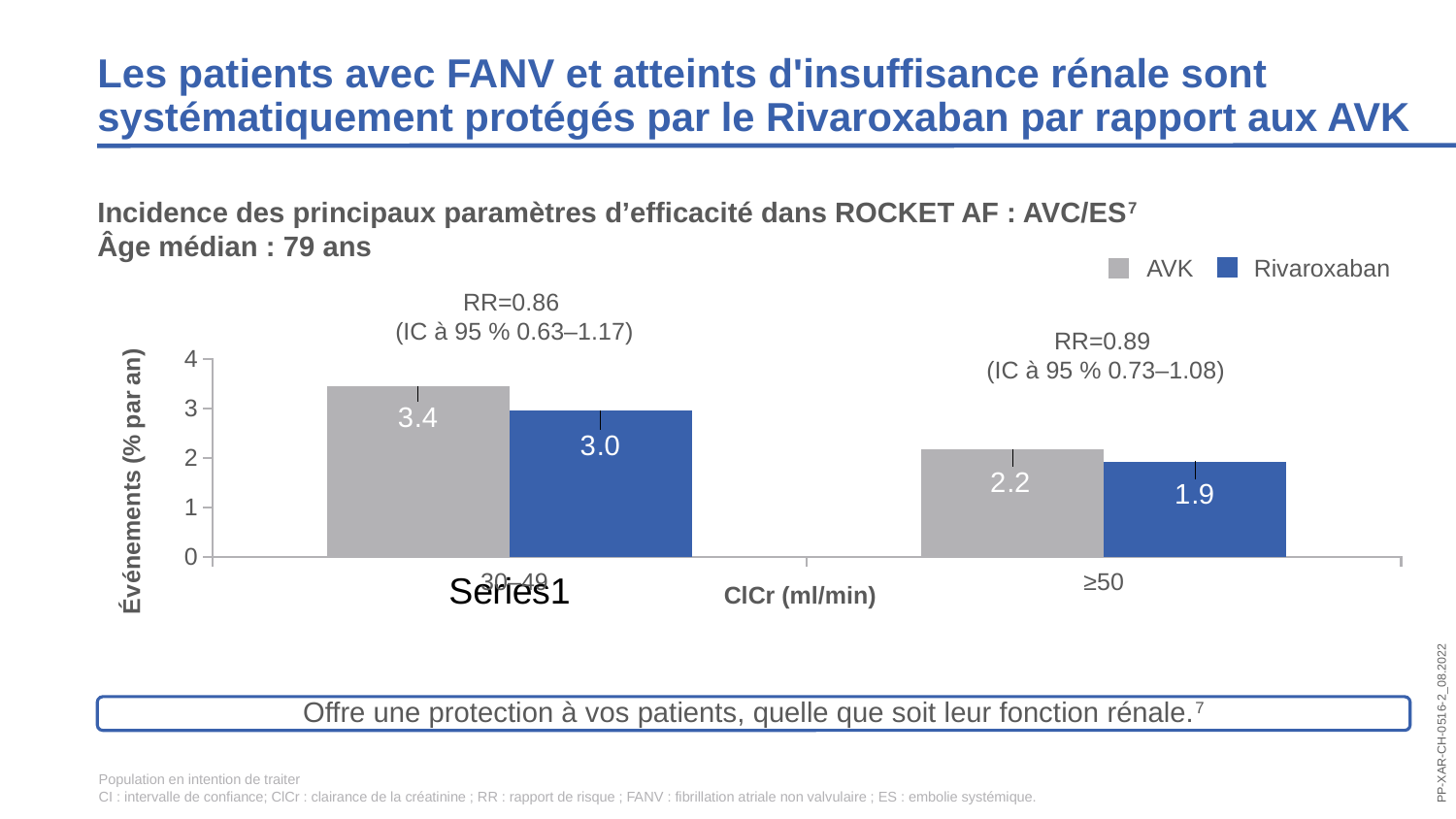
What is the Rivaroxaban value for the ClCr ≥50 ml/min group? 1.9 What is the label of the y axis of the chart? Événements (% par an) Which bar has the lowest value on the chart? Rivaroxaban in the ClCr ≥50 ml/min group (1.9) What is the difference between the AVK and Rivaroxaban values in the ClCr ≥50 ml/min group? 0.3 What is the AVK value for the ClCr ≥50 ml/min group? 2.2 Which bar has the highest value on the chart? AVK in the ClCr 30–49 ml/min group (3.4) In the ClCr ≥50 ml/min group, which series has the larger value, AVK or Rivaroxaban? AVK What is the difference between the AVK and Rivaroxaban values in the ClCr 30–49 ml/min group? 0.4 How many series does the legend list? 2 What is the AVK value for the ClCr 30–49 ml/min group? 3.4 What is the Rivaroxaban value for the ClCr 30–49 ml/min group? 3.0 What kind of chart is shown on the slide? Bar chart